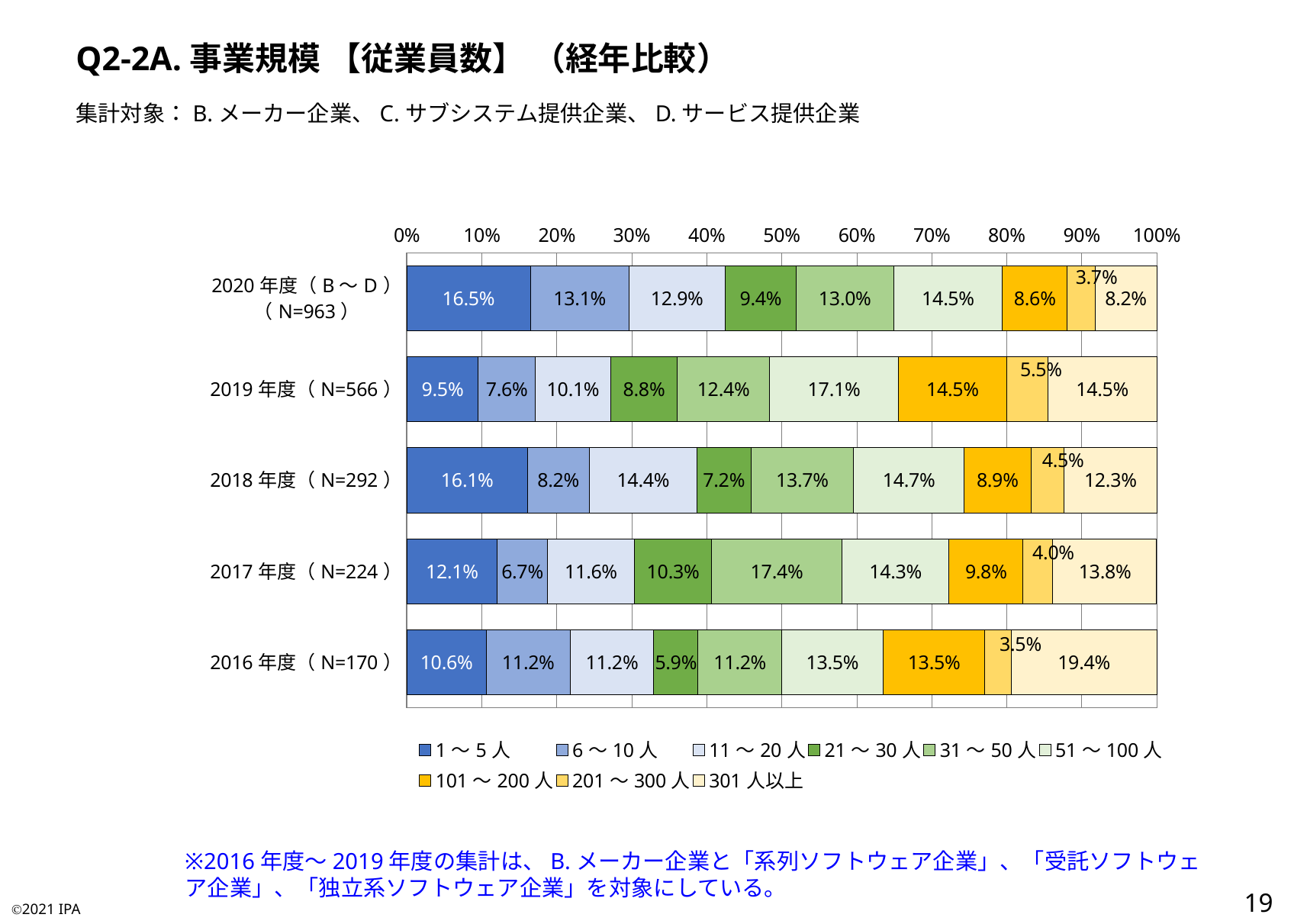
What is the value for 301人以上 in 2016年度 (N=170)? 19.4% What kind of chart is shown on the slide? Stacked bar chart What is the value for 201～300人 in 2018年度 (N=292)? 4.5% Which fiscal year has the highest value for 1～5人? 2020年度 (B～D) (N=963) Which fiscal year has the lowest value for 21～30人? 2016年度 (N=170) What is the value for 51～100人 in 2019年度 (N=566)? 17.1% What is the sample size (N) shown for 2019年度? N=566 Which is larger: the 31～50人 value in 2017年度 or in 2018年度? 2017年度 (17.4%) How many series does the legend list? 9 What is the difference between the 301人以上 values for 2016年度 and 2020年度? 11.2% How many fiscal-year categories are plotted on the chart? 5 What is the value for 1～5人 in 2020年度 (B～D) (N=963)? 16.5%